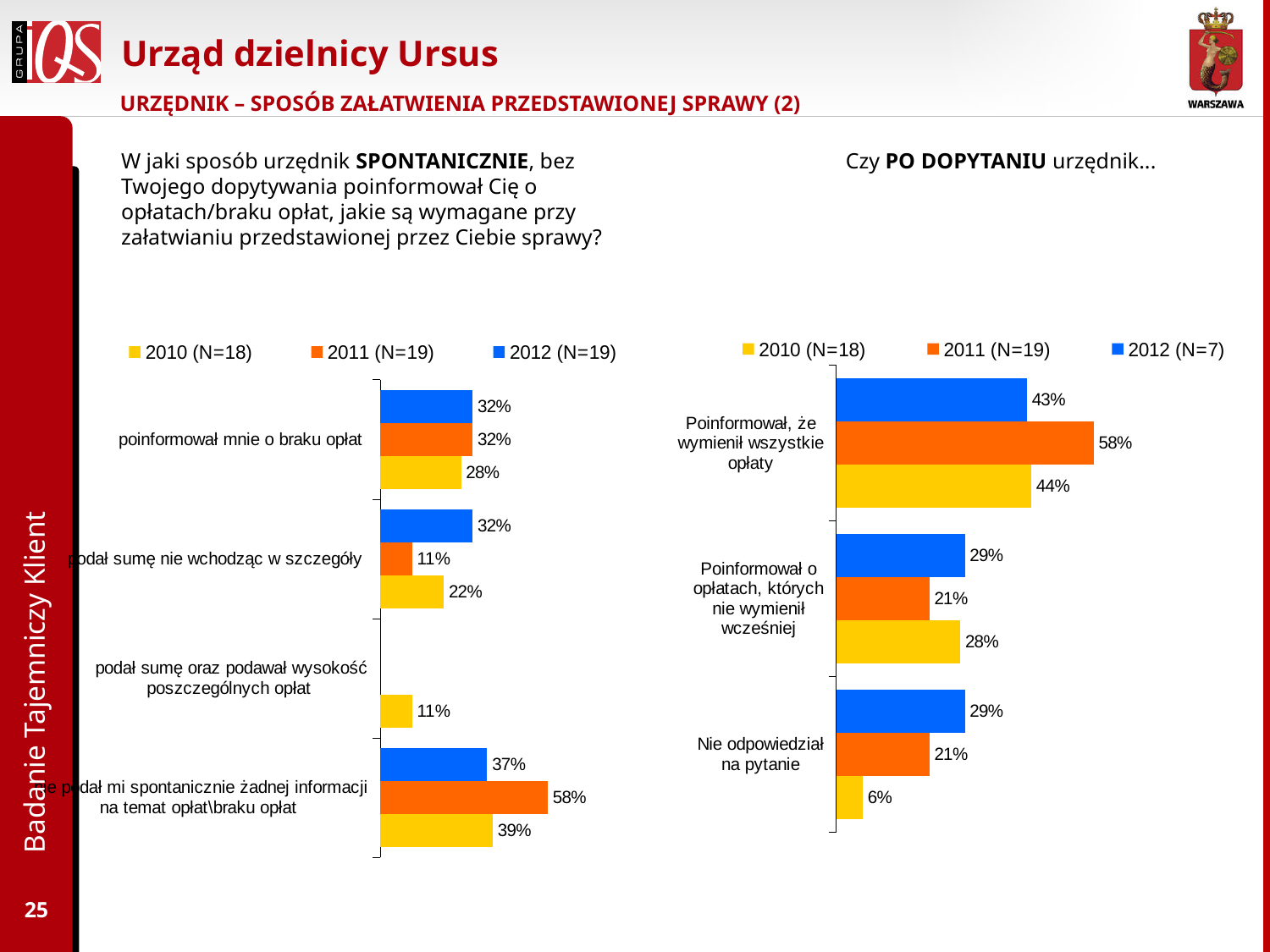
In the left chart, what is the 2010 value for 'podał sumę nie wchodząc w szczegóły'? 22% In the right chart, which is larger for 'Poinformował o opłatach, których nie wymienił wcześniej': the 2010 value or the 2011 value? 2010 (28%) In the right chart, what is the difference between the 2012 and 2011 values for 'Nie odpowiedział na pytanie'? 8 percentage points In the left chart (spontaneous information about fees), what is the 2011 value for 'nie podał mi spontanicznie żadnej informacji na temat opłat\braku opłat'? 58% How many categories are shown in the left chart? 4 What type of chart is the right chart? Bar chart In the right chart, what is the 2010 value for 'Nie odpowiedział na pytanie'? 6% In the left chart, which year has the lowest value for 'podał sumę nie wchodząc w szczegóły'? 2011 (N=19) How many series does the legend of the right chart list? 3 In the right chart, which year has the highest value for 'Poinformował, że wymienił wszystkie opłaty'? 2011 (N=19) In the right chart ('Czy PO DOPYTANIU urzędnik...'), what is the 2012 value for 'Poinformował, że wymienił wszystkie opłaty'? 43% In the left chart, what is the difference between the 2011 and 2012 values for 'nie podał mi spontanicznie żadnej informacji na temat opłat\braku opłat'? 21 percentage points